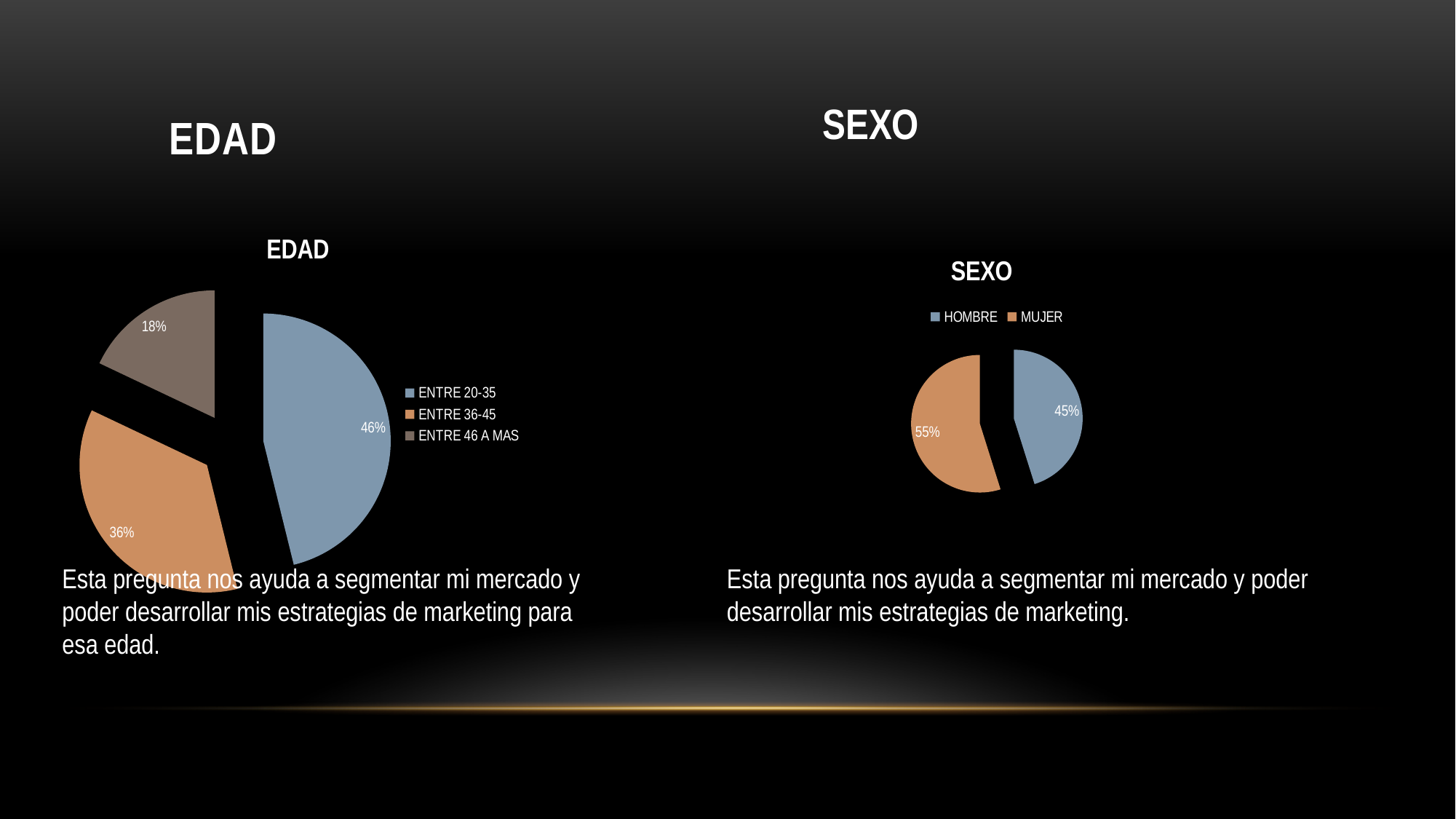
In the EDAD chart, how many categories are shown? 3 In the EDAD chart, what share does ENTRE 46 A MAS have? 18% In the EDAD chart, what share does ENTRE 36-45 have? 36% In the SEXO chart, which is larger, HOMBRE or MUJER? MUJER In the EDAD chart, which category has the largest slice? ENTRE 20-35 In the EDAD chart, what share does ENTRE 20-35 have? 46% In the SEXO chart, what share does HOMBRE have? 45% In the EDAD chart, which category has the smallest slice? ENTRE 46 A MAS In the SEXO chart, what is the difference between the MUJER and HOMBRE shares? 10% What type of chart is the SEXO chart? Pie chart In the EDAD chart, what is the difference between the ENTRE 20-35 and ENTRE 46 A MAS shares? 28% In the SEXO chart, what share does MUJER have? 55%